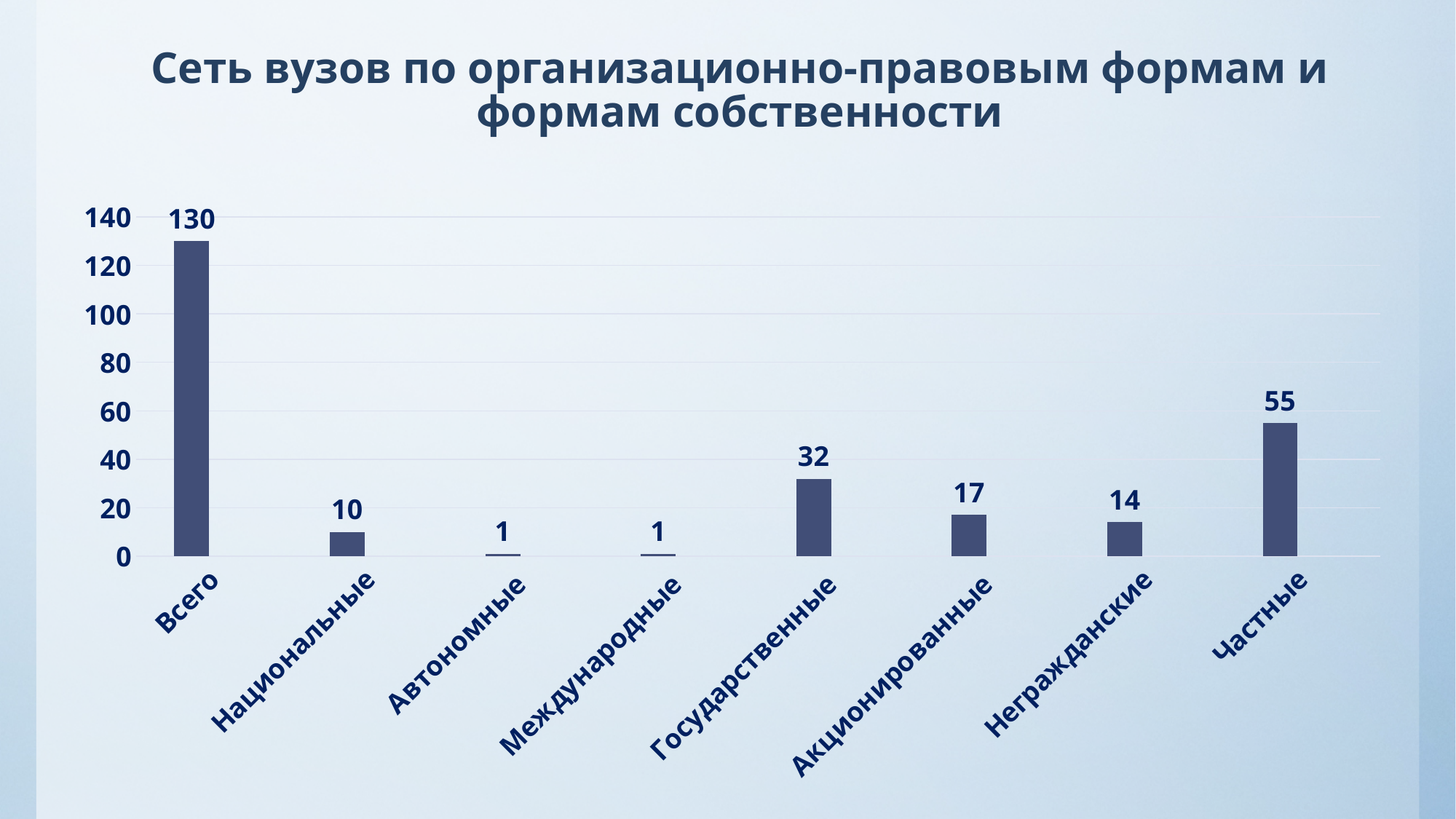
What is the value for Негражданские? 14 How many categories are shown on the x axis? 8 Which category has the highest value? Всего What is the value for Акционированные? 17 Which is larger, the value for Национальные or the value for Негражданские? Негражданские What is the value for Частные? 55 What is the difference between the values for Частные and Государственные? 23 What kind of chart is shown on the slide? Bar chart Excluding Всего, which category has the highest value? Частные What is the title of the chart? Сеть вузов по организационно-правовым формам и формам собственности What is the value for Всего? 130 What is the value for Государственные? 32